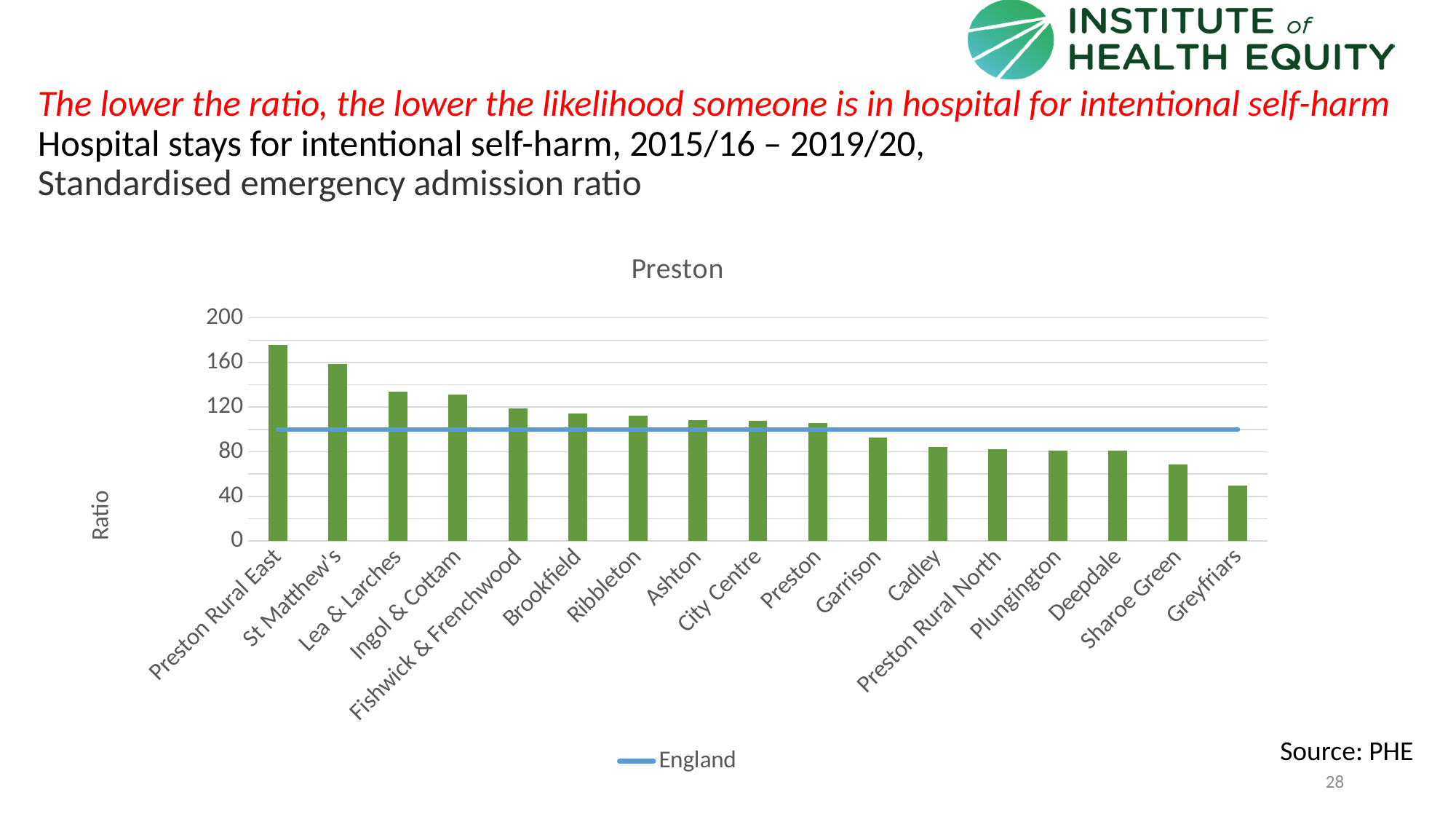
Do the bar values rise or fall moving from left to right along the x axis? fall How many entries does the chart legend list? 1 Which ward has the lowest standardised emergency admission ratio? Greyfriars Which ward has the highest standardised emergency admission ratio? Preston Rural East What kind of chart is shown on the slide? bar chart Is the value for Preston Rural East greater or less than 160? greater How many wards are plotted on the chart? 17 Which is larger, the value for St Matthew's or the value for Cadley? St Matthew's Is the value for Lea & Larches greater or less than 120? greater Is the value for Sharoe Green greater or less than 80? less What is the title of the chart? Preston